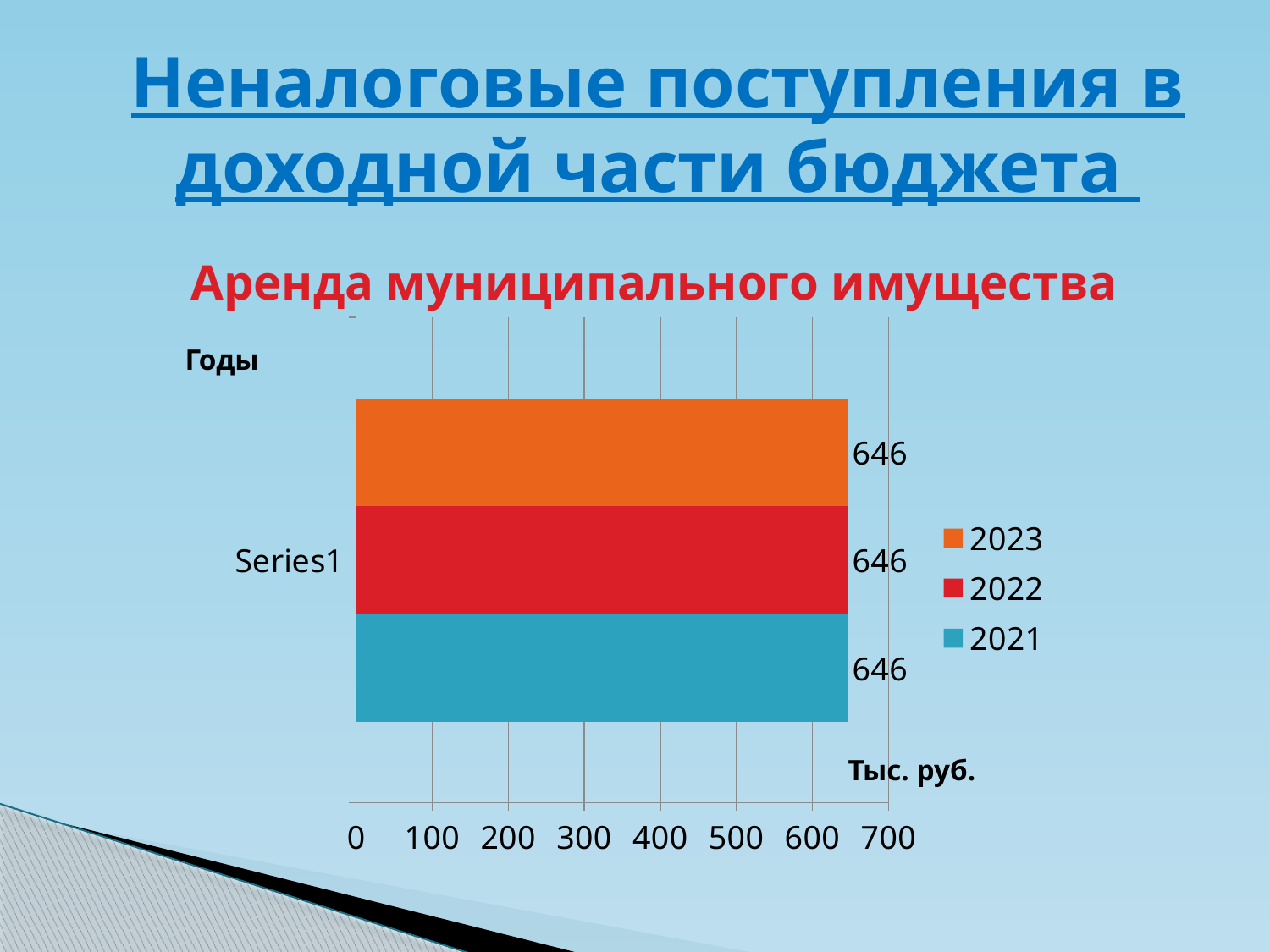
How many series does the legend list? 3 How many categories are shown on the vertical axis of the chart? 1 Is the value for 2021 greater or less than 700? less What is the value for 2022 in the chart? 646 What unit is shown next to the horizontal axis of the chart? Тыс. руб. What is the title of the chart? Аренда муниципального имущества What is the value for 2021 in the chart? 646 What kind of chart is shown on the slide? Bar chart What is the difference between the values for 2023 and 2021? 0 Is the value for 2022 greater or less than 600? greater What is the value for 2023 in the chart? 646